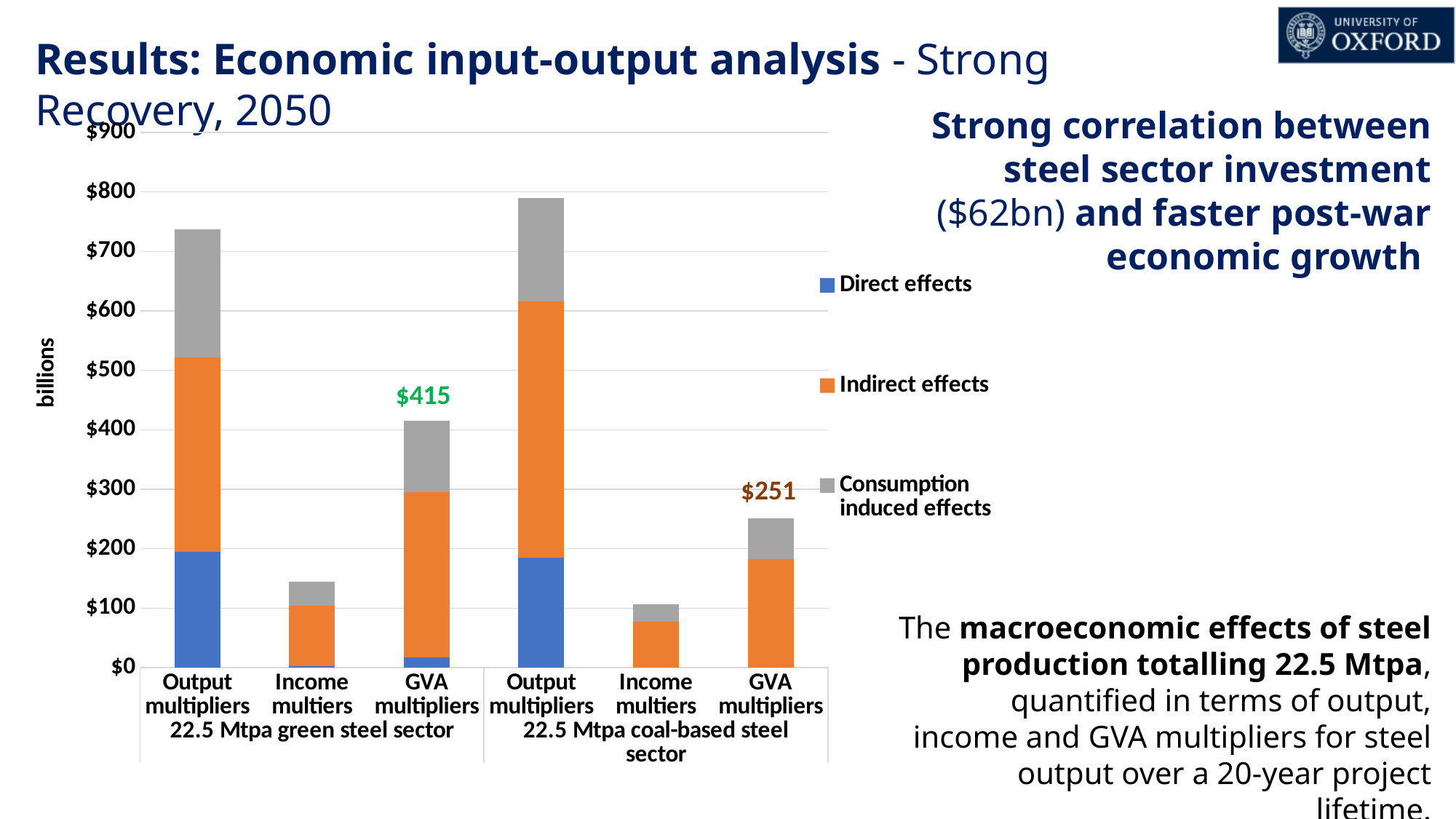
What is the labelled total for GVA multipliers in the 22.5 Mtpa green steel sector? $415 What is the difference between the GVA multipliers total for the green steel sector and the coal-based steel sector? $164 Which bar is the shortest in the chart? Income multiers, 22.5 Mtpa coal-based steel sector How many bars are plotted in the chart? 6 Which sector has the larger GVA multipliers total, green steel or coal-based steel? Green steel sector What kind of chart is shown on the slide? Stacked bar chart Is the total for Income multiers in the green steel sector greater or less than $200? less What is the label on the vertical axis of the chart? billions Is the total for Output multipliers in the green steel sector greater or less than $700? greater How many series does the chart legend list? 3 What is the labelled total for GVA multipliers in the 22.5 Mtpa coal-based steel sector? $251 Which bar is the tallest in the chart? Output multipliers, 22.5 Mtpa coal-based steel sector